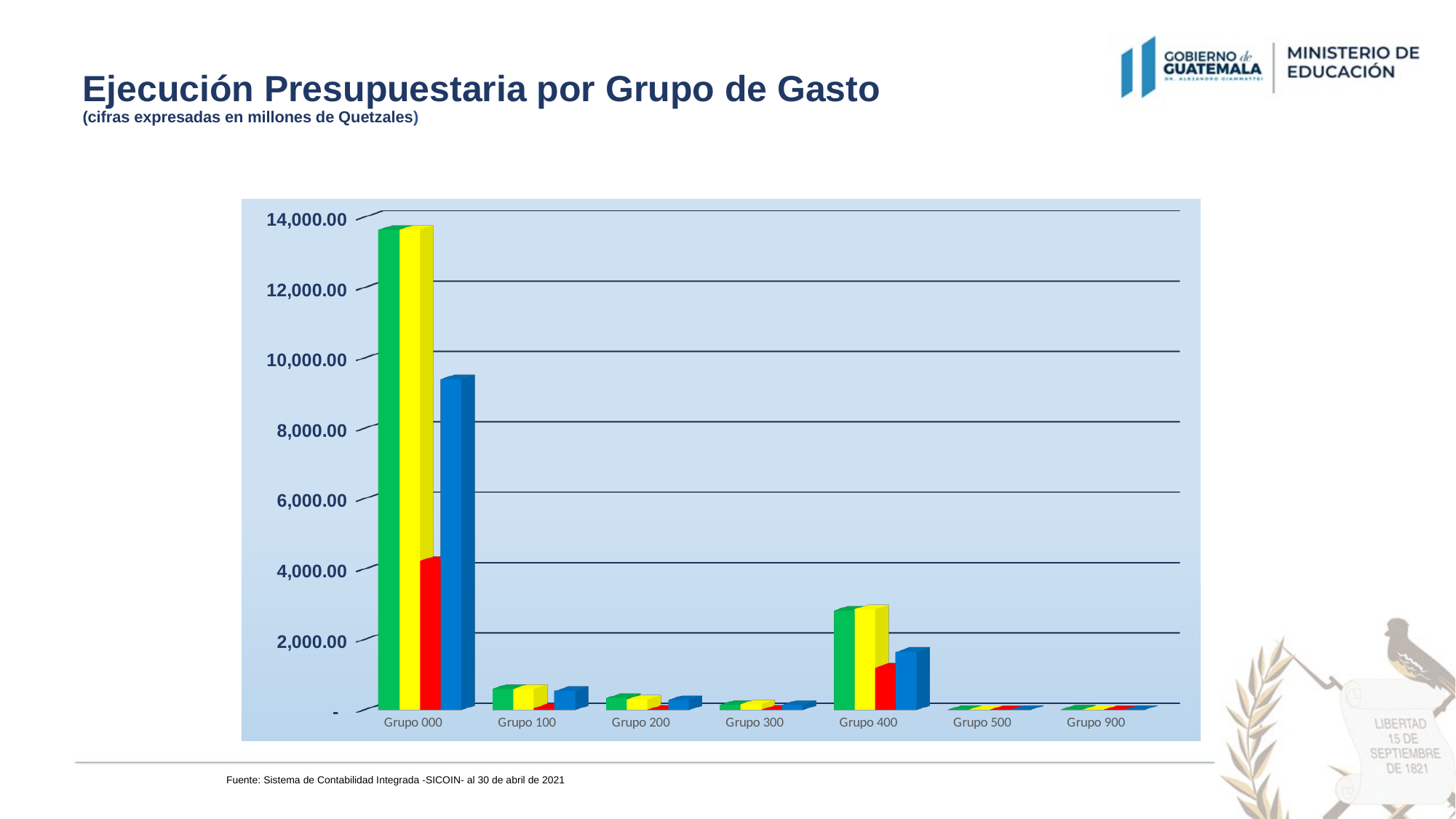
Which group has the larger blue bar, Grupo 000 or Grupo 400? Grupo 000 Is the blue bar for Grupo 000 greater or less than 10,000.00? less What is the title of the slide containing the chart? Ejecución Presupuestaria por Grupo de Gasto Which group has the highest bars in the chart? Grupo 000 How many expense groups (categories) are shown on the x axis? 7 What kind of chart is shown on the slide? bar chart Is the green bar for Grupo 000 greater or less than 12,000.00? greater In what units are the figures in the chart expressed, according to the subtitle? millones de Quetzales Is the red bar for Grupo 000 greater or less than 4,000.00? greater Which group has the larger green bar, Grupo 100 or Grupo 400? Grupo 400